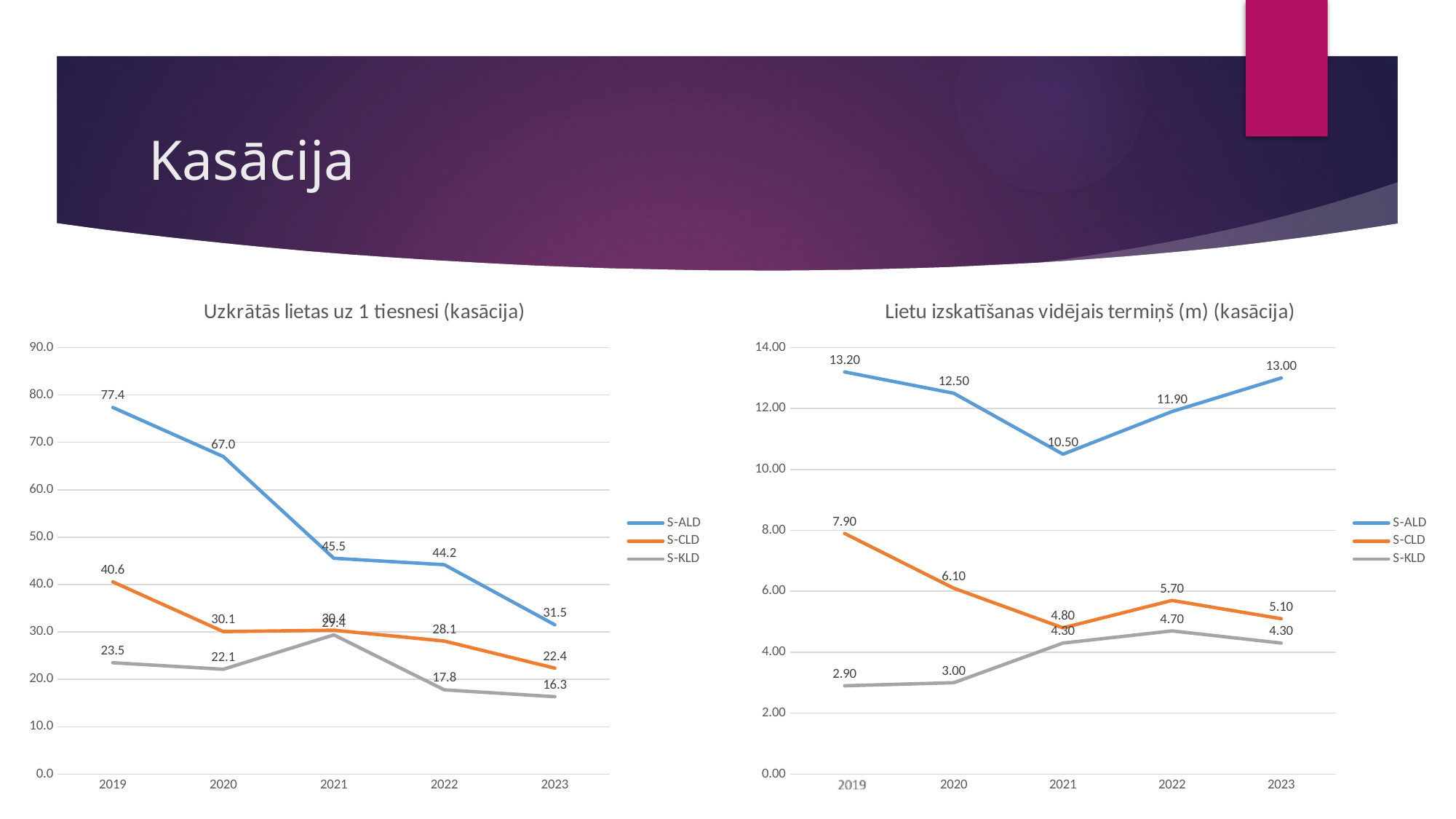
In the chart 'Lietu izskatīšanas vidējais termiņš (m) (kasācija)', what is the value for S-CLD in 2019? 7.90 What kind of chart is 'Lietu izskatīšanas vidējais termiņš (m) (kasācija)'? line chart In the chart 'Uzkrātās lietas uz 1 tiesnesi (kasācija)', how many series does the legend list? 3 In the chart 'Uzkrātās lietas uz 1 tiesnesi (kasācija)', what is the value for S-KLD in 2023? 16.3 In the chart 'Uzkrātās lietas uz 1 tiesnesi (kasācija)', what is the value for S-ALD in 2019? 77.4 In the chart 'Uzkrātās lietas uz 1 tiesnesi (kasācija)', what is the difference between the S-ALD values in 2019 and 2023? 45.9 In the chart 'Lietu izskatīšanas vidējais termiņš (m) (kasācija)', what is the value for S-ALD in 2021? 10.50 In the chart 'Lietu izskatīšanas vidējais termiņš (m) (kasācija)', in which year is the S-KLD value highest? 2022 In the chart 'Lietu izskatīšanas vidējais termiņš (m) (kasācija)', which is larger in 2022: S-CLD or S-KLD? S-CLD In the chart 'Lietu izskatīšanas vidējais termiņš (m) (kasācija)', how many years are shown on the x axis? 5 In the chart 'Uzkrātās lietas uz 1 tiesnesi (kasācija)', does the S-ALD line rise or fall from 2019 to 2023? fall In the chart 'Uzkrātās lietas uz 1 tiesnesi (kasācija)', in which year is the S-ALD value lowest? 2023